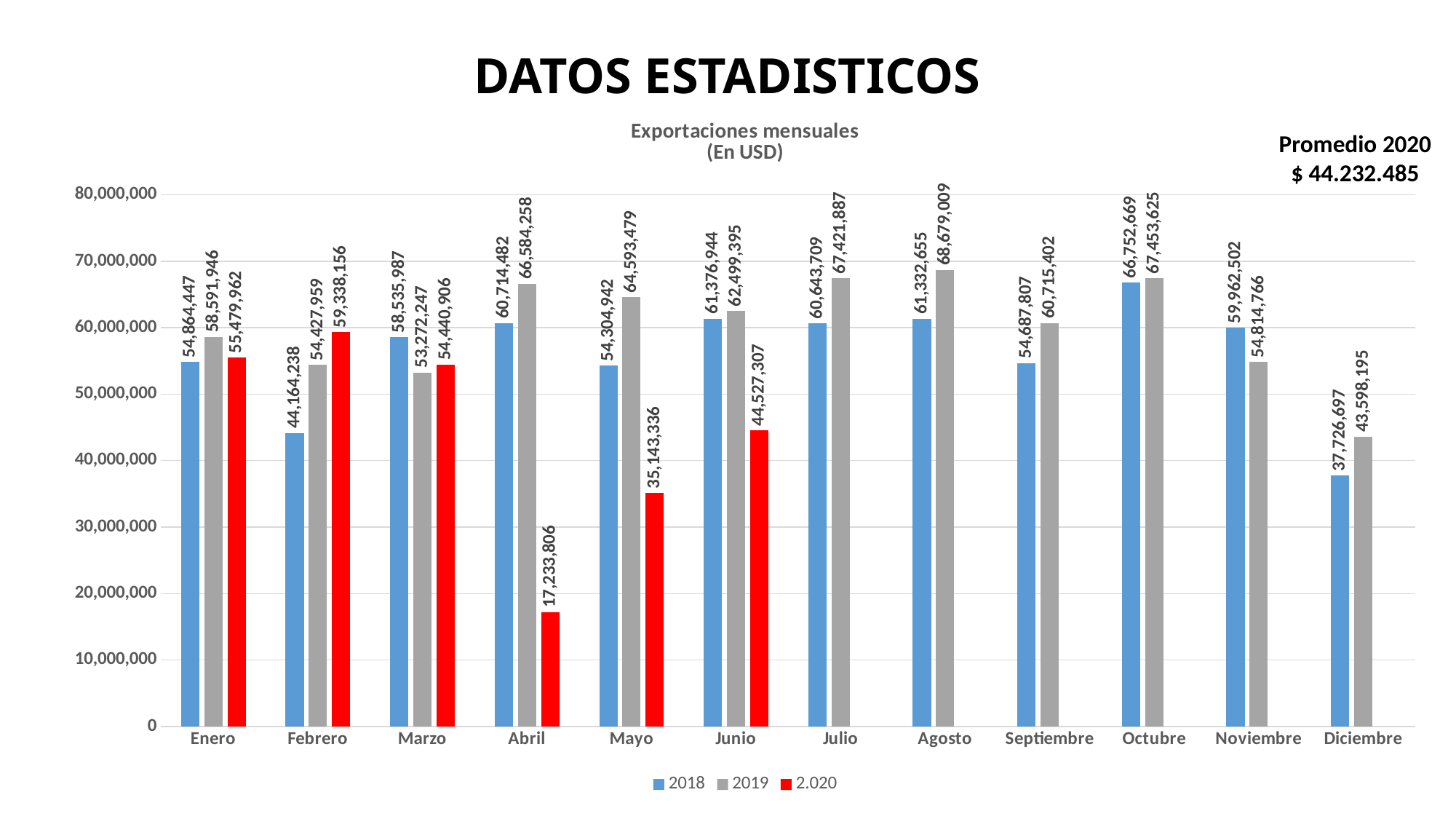
How many months are shown on the x axis? 12 What is the title of the chart? Exportaciones mensuales (En USD) Which month has the highest value for the 2018 series? Octubre What is the difference between the 2019 and 2.020 values in Abril? 49,350,452 What kind of chart is shown? Bar chart Which month has the lowest value for the 2.020 series? Abril Which month has the highest value for the 2019 series? Agosto Which is larger in Febrero, the 2018 value or the 2.020 value? 2.020 How many series does the legend list? 3 What is the value for 2018 in Diciembre? 37,726,697 What is the value for 2019 in Abril? 66,584,258 What is the value for 2.020 in Mayo? 35,143,336